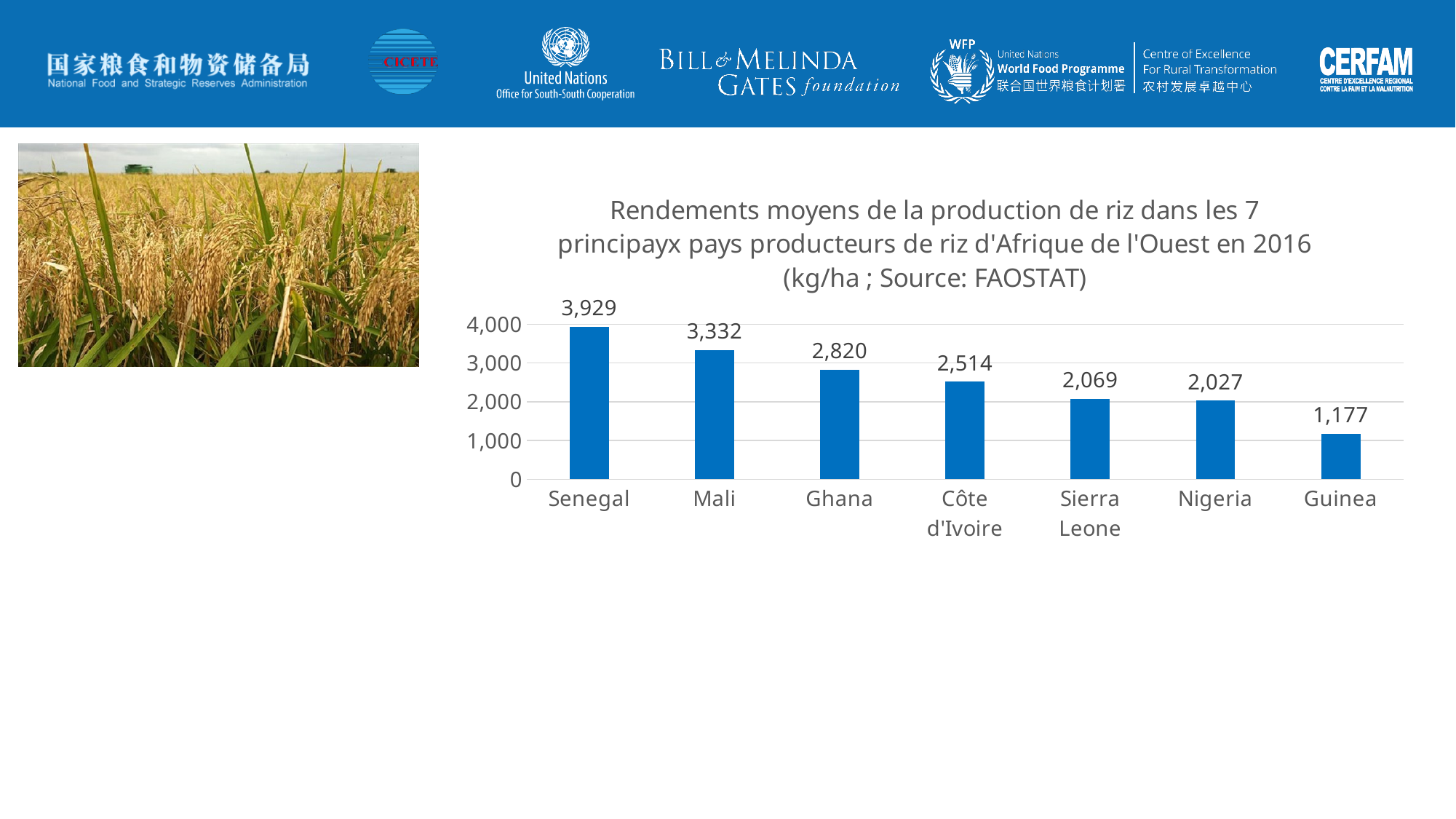
Is the value for Mali greater or less than 3,000? greater What is the value shown for Côte d'Ivoire? 2,514 Which country has the lowest rice yield on the chart? Guinea Which has a larger value, Sierra Leone or Nigeria? Sierra Leone How many countries are shown on the chart? 7 What kind of chart is shown on the slide? Bar chart What is the difference between the values for Senegal and Mali? 597 Do the values rise or fall from left to right across the chart? Fall What is the average rice yield shown for Senegal? 3,929 Which country has the highest rice yield on the chart? Senegal What is the value shown for Ghana? 2,820 What is the difference between the values for Nigeria and Guinea? 850